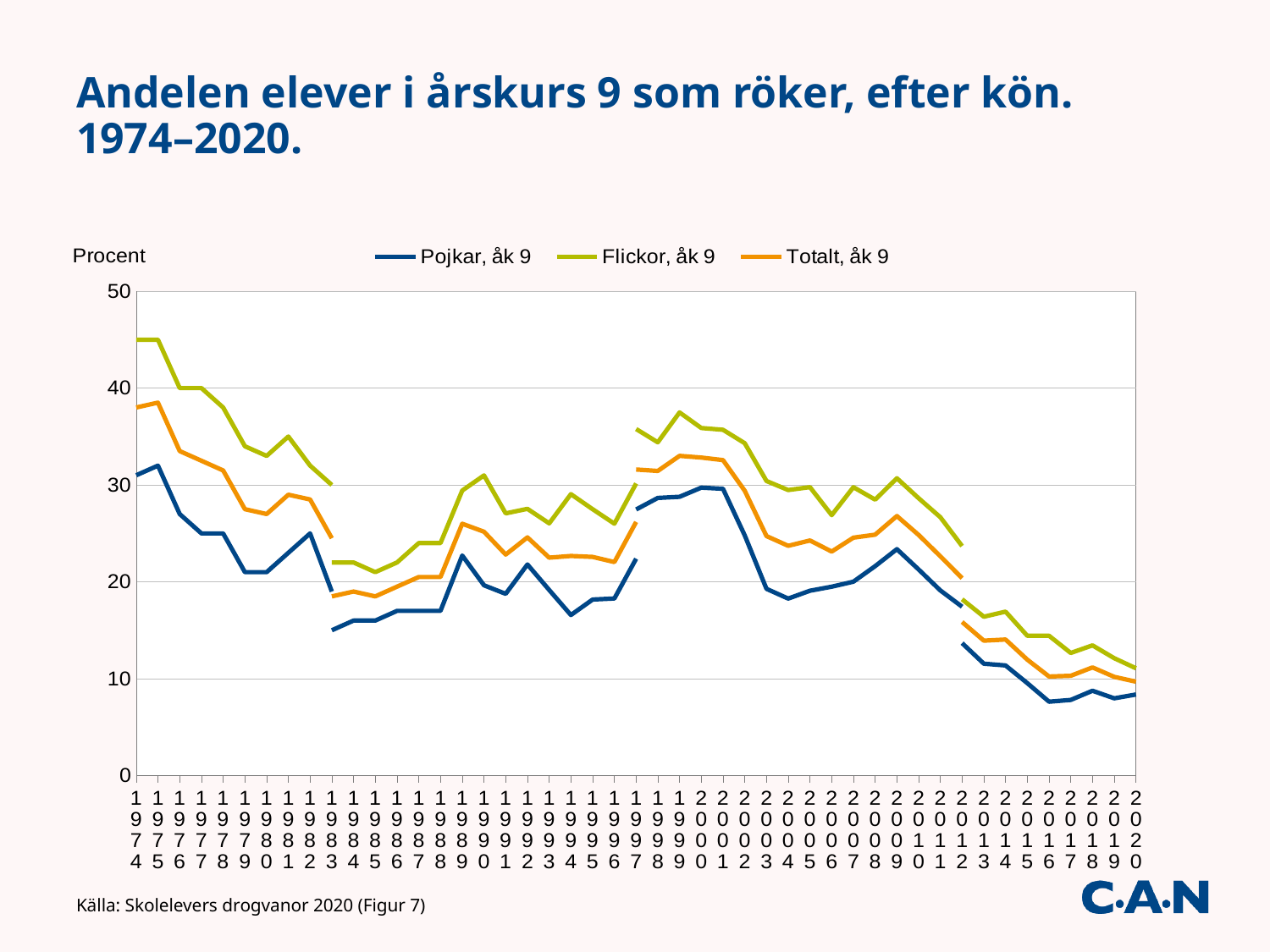
How many series does the legend list? 3 Is the value for Flickor, åk 9 in 1974 greater or less than 40? greater Which series has the highest value in 1974? Flickor, åk 9 Do the values for Totalt, åk 9 generally rise or fall from 1974 to 2020? fall What is the title of the chart? Andelen elever i årskurs 9 som röker, efter kön. 1974–2020. Is the value for Totalt, åk 9 in 1974 greater or less than 40? less Is the value for Pojkar, åk 9 in 2020 greater or less than 10? less Which is larger in 1974, the value for Flickor, åk 9 or the value for Pojkar, åk 9? Flickor, åk 9 Which series has the lowest value in 2020? Pojkar, åk 9 What kind of chart is shown on the slide? line chart How many years are shown along the x axis? 47